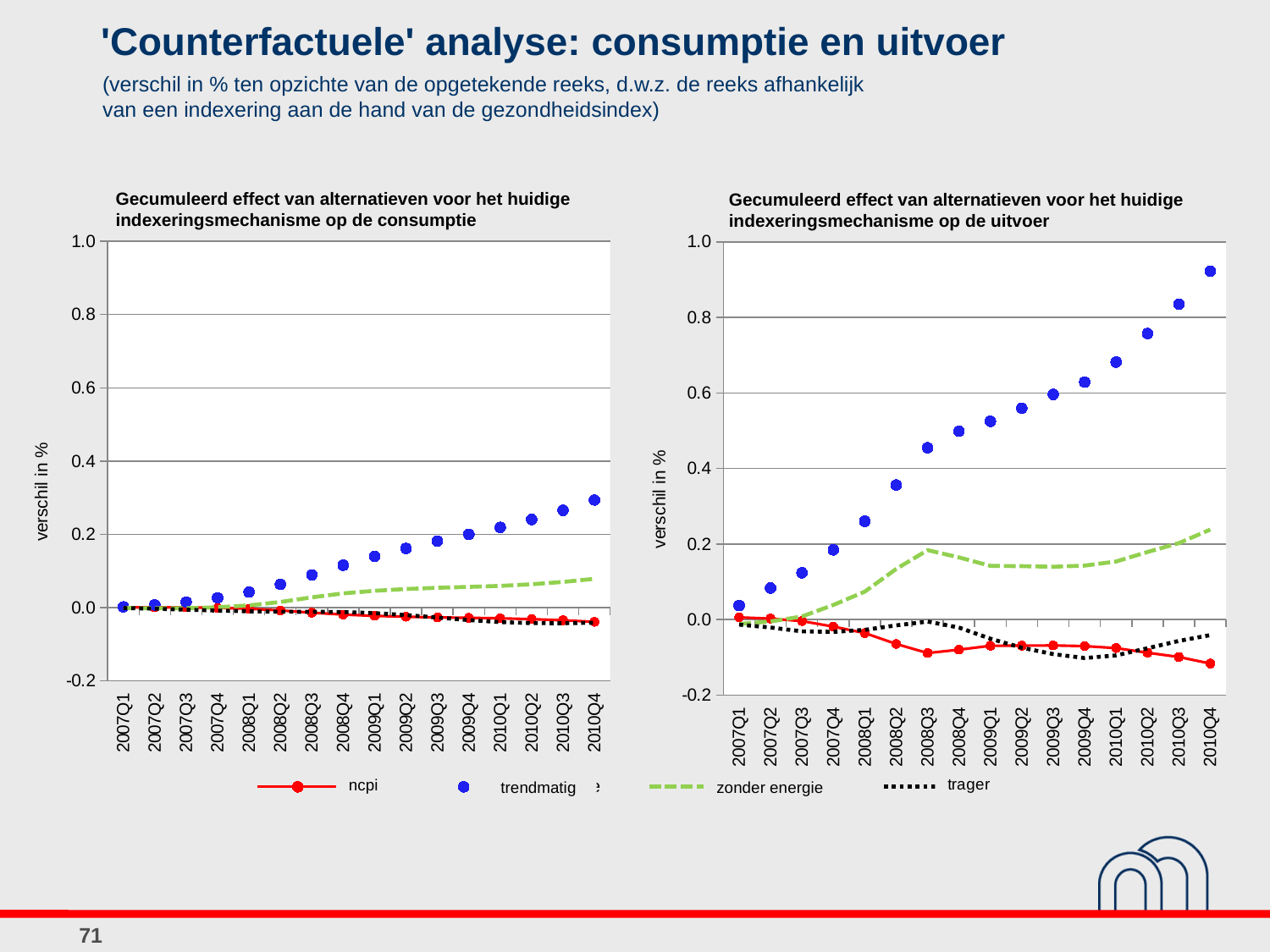
In the right chart (uitvoer), does the ncpi series rise or fall from 2007Q1 to 2010Q4? fall What is the y-axis label of the left chart (consumptie)? verschil in % What kind of chart is the left chart, 'Gecumuleerd effect van alternatieven voor het huidige indexeringsmechanisme op de consumptie'? line chart How many series does the legend list for the charts on the slide? 4 In the right chart (uitvoer), is the value for trendmatig at 2010Q4 greater or less than 0.8? greater In the left chart (consumptie), is the value for trendmatig at 2010Q4 greater or less than 0.4? less In the right chart (uitvoer), is the value for trendmatig at 2009Q1 greater or less than 0.4? greater In the right chart (uitvoer), which series has the lowest value at 2010Q4? ncpi In the right chart (uitvoer), which series has the highest value at 2010Q4? trendmatig In the right chart (uitvoer), how many quarters are shown on the x axis? 16 In the right chart (uitvoer), does the trendmatig series rise or fall from 2007Q1 to 2010Q4? rise